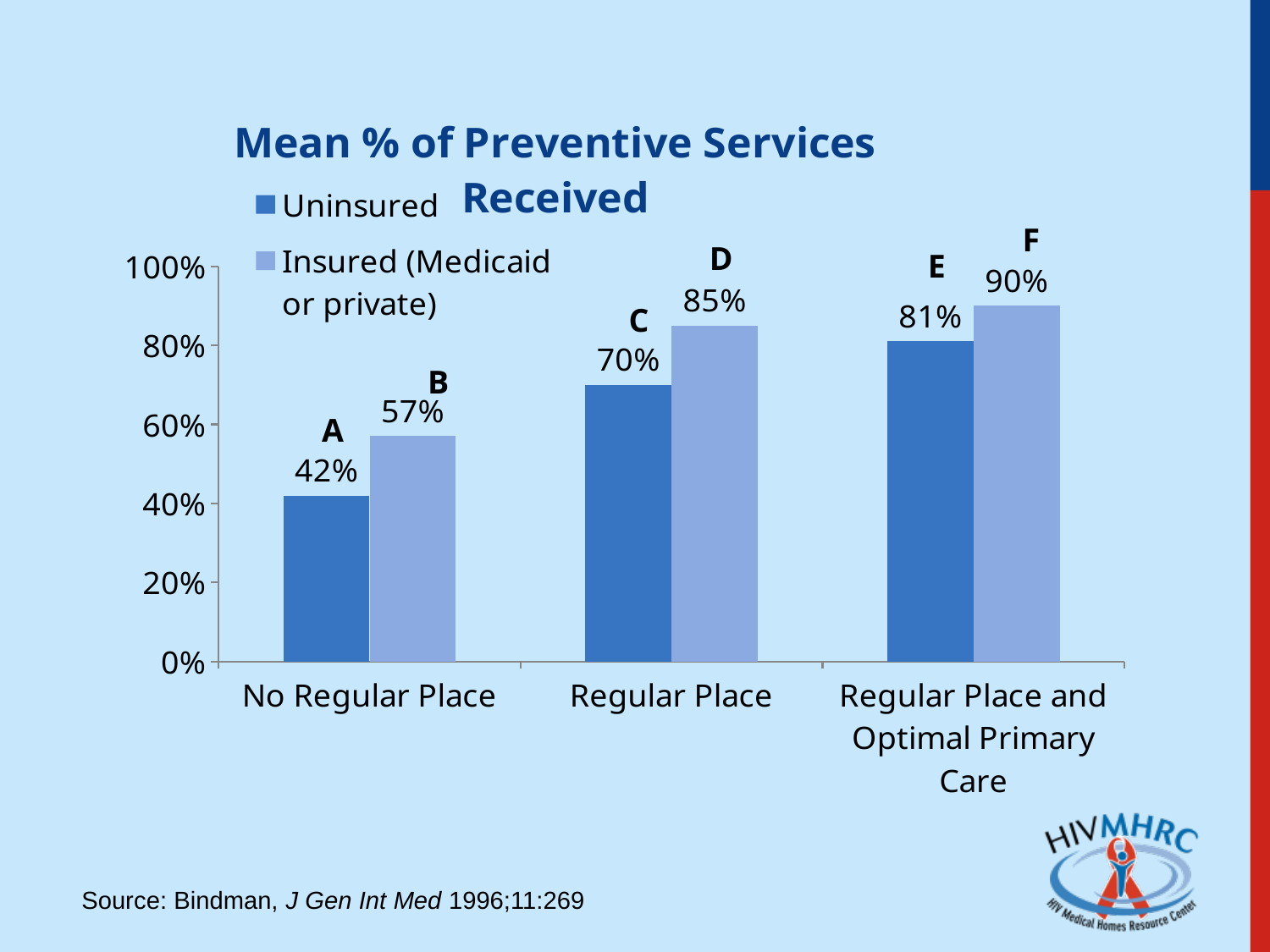
What is the value for Insured (Medicaid or private) in the Regular Place category? 85% How many series does the legend list? 2 Which category has the highest value for the Insured (Medicaid or private) series? Regular Place and Optimal Primary Care How many categories are shown on the x axis? 3 Which is larger: the Uninsured value for Regular Place or the Insured value for No Regular Place? Uninsured value for Regular Place Which category has the lowest value for the Uninsured series? No Regular Place Do the Uninsured values rise or fall from left to right across the categories? Rise What kind of chart is shown on the slide? Bar chart What is the difference between the Uninsured values for Regular Place and Regular Place and Optimal Primary Care? 11% What is the value for Uninsured in the No Regular Place category? 42% What is the difference between the Insured and Uninsured values in the No Regular Place category? 15% What is the value for Uninsured in the Regular Place and Optimal Primary Care category? 81%